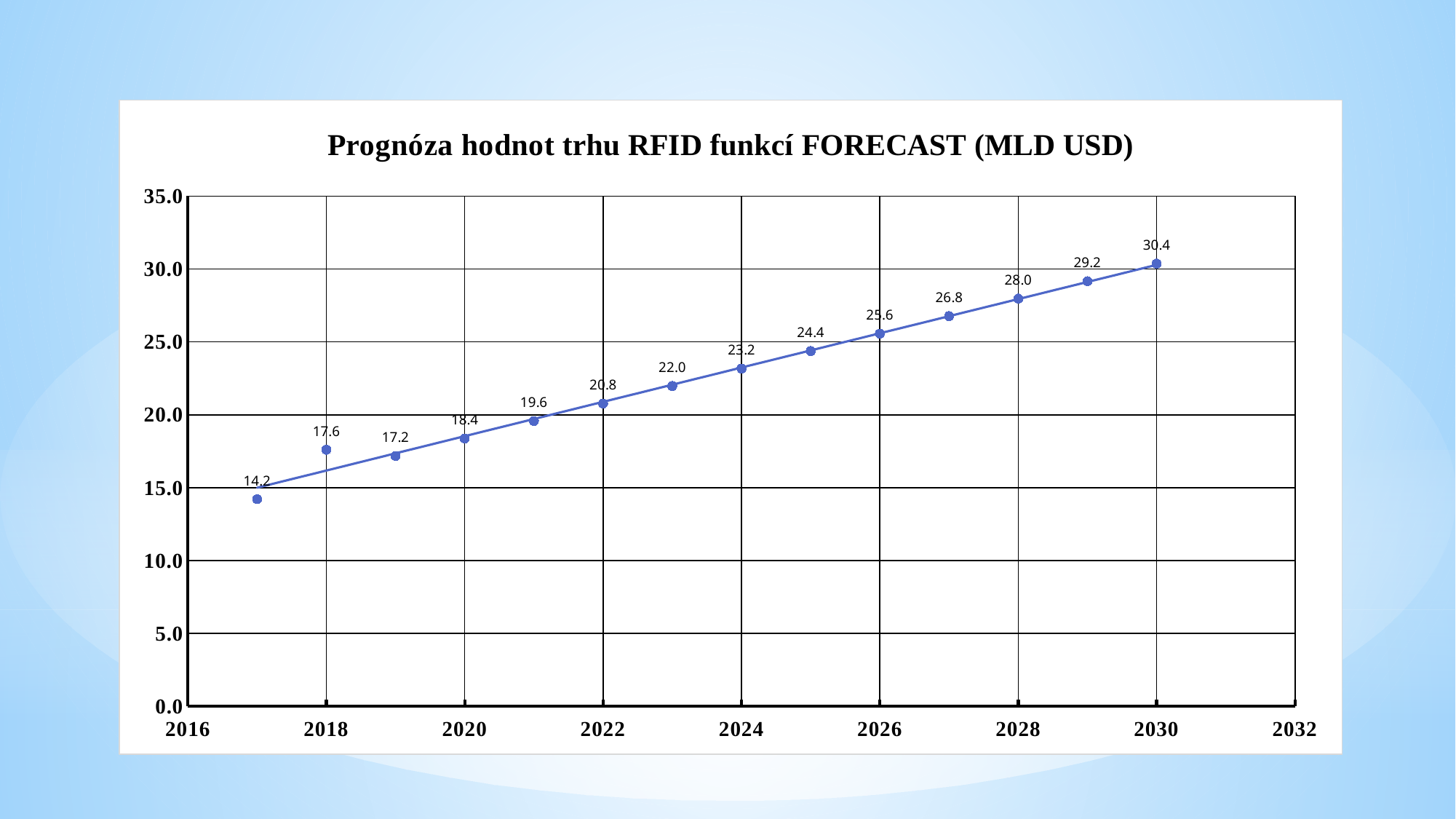
What is the value for 2030? 30.4 Which year has the highest value? 2030 What is the value for 2017? 14.2 What is the value for 2019? 17.2 What is the value for 2024? 23.2 Which year has the lowest value? 2017 What is the difference between the values for 2030 and 2017? 16.2 Which is larger, the value for 2018 or the value for 2019? 2018 How many data points are plotted on the chart? 14 What kind of chart is shown on the slide? Scatter chart with a trend line Do the values generally rise or fall from 2017 to 2030? Rise Is the value for 2026 greater or less than 25.0? greater